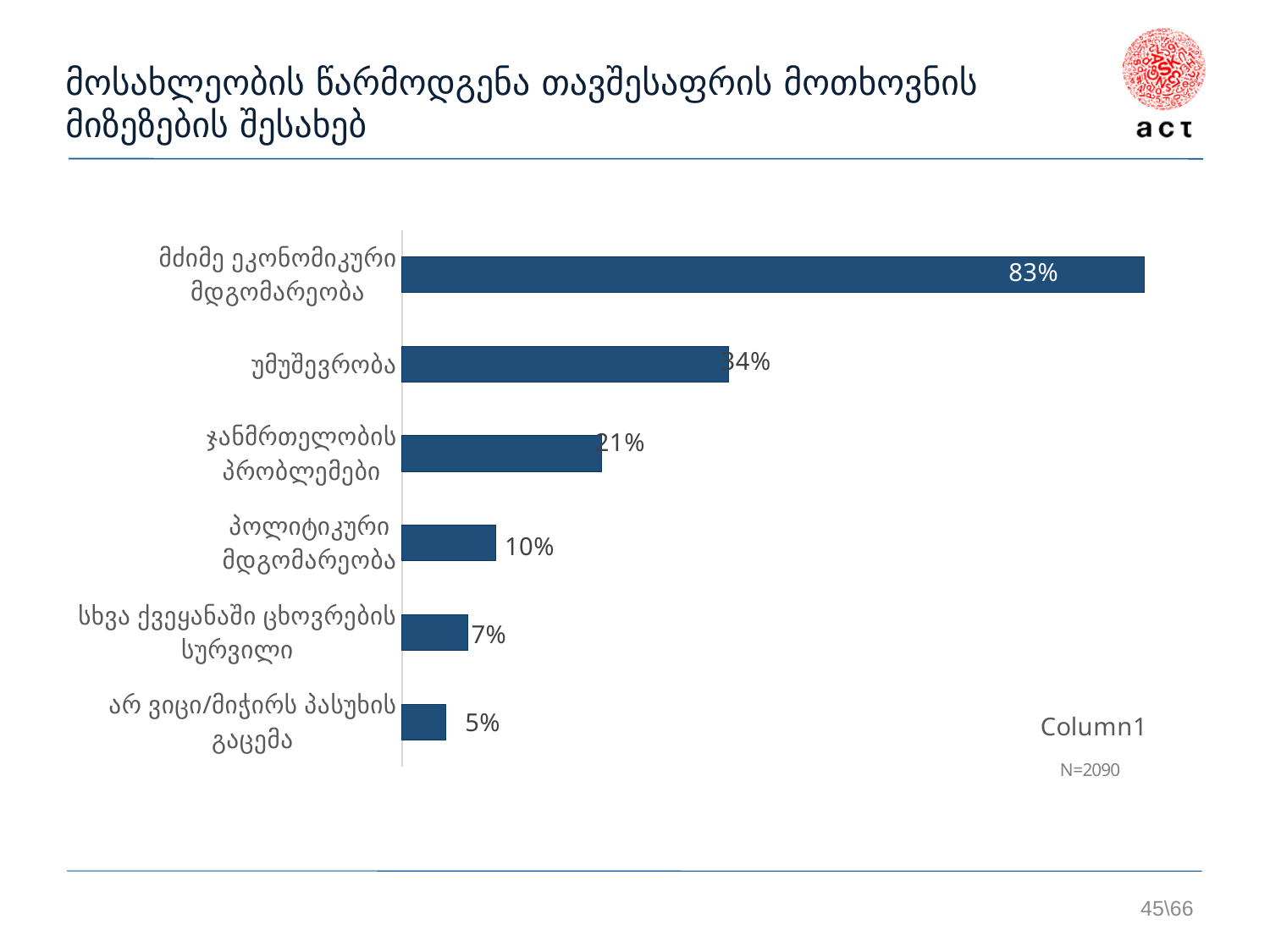
What is the sample size (N) noted on the chart? N=2090 Which is larger, the value for ჯანმრთელობის პრობლემები or the value for პოლიტიკური მდგომარეობა? ჯანმრთელობის პრობლემები What is the value for უმუშევრობა? 34% What is the value for სხვა ქვეყანაში ცხოვრების სურვილი? 7% What is the value for პოლიტიკური მდგომარეობა? 10% What is the difference between the values for მძიმე ეკონომიკური მდგომარეობა and უმუშევრობა? 49% What is the value for არ ვიცი/მიჭირს პასუხის გაცემა? 5% Which category has the lowest value? არ ვიცი/მიჭირს პასუხის გაცემა Which category has the highest value? მძიმე ეკონომიკური მდგომარეობა What is the value for მძიმე ეკონომიკური მდგომარეობა? 83% How many categories are shown in the chart? 6 What kind of chart is shown on the slide? bar chart